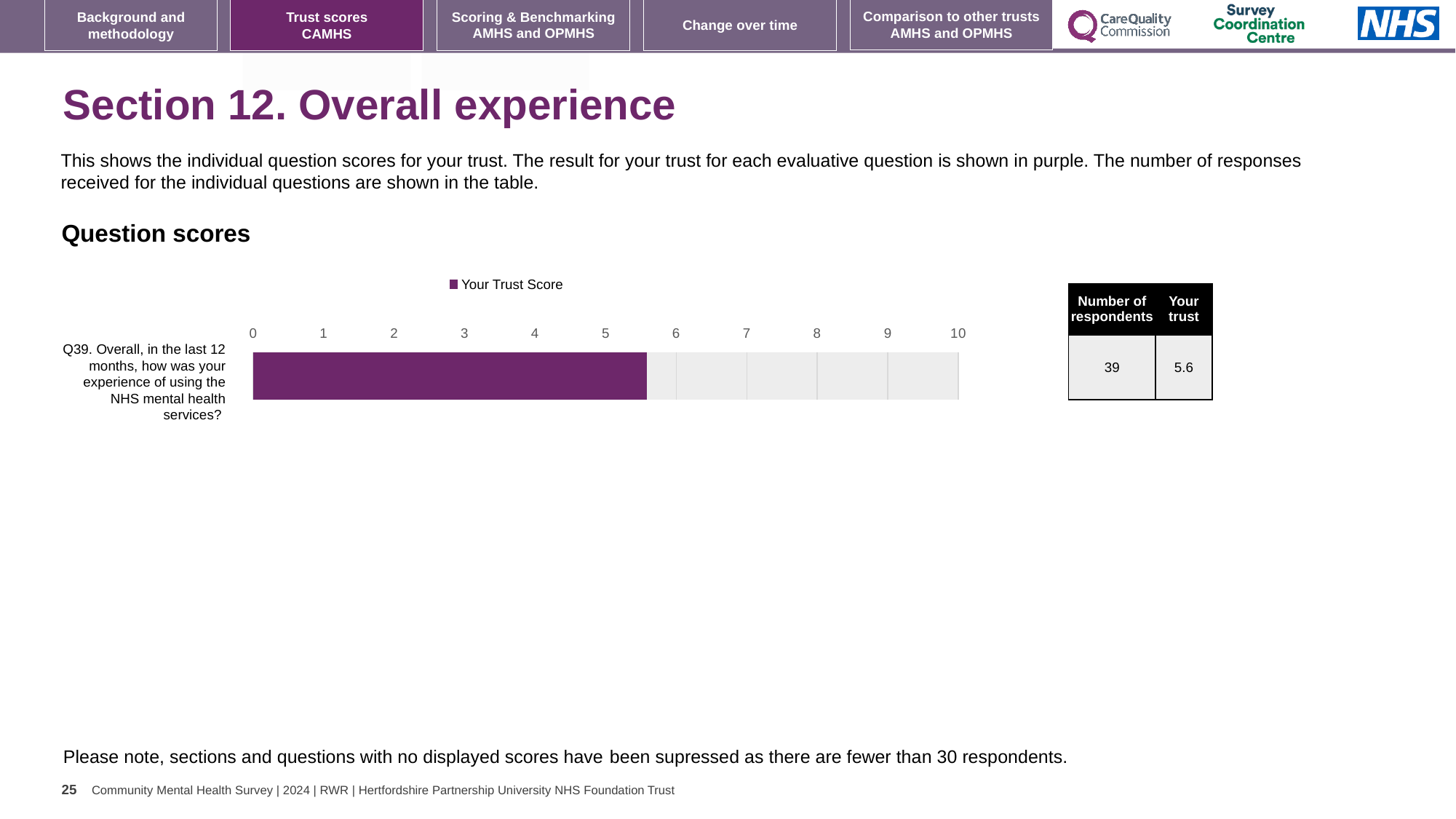
What is the highest value shown on the chart's axis? 10 Is the trust score for Q39 greater or less than 6? less What kind of chart is shown under 'Question scores'? bar chart How many questions (categories) are plotted in the chart? 1 Is the trust score for Q39 greater or less than 8? less What is the name of the series shown in the chart legend? Your Trust Score What is the trust score for Q39 as shown in the table next to the chart? 5.6 Is the trust score for Q39 greater or less than 5? greater How many series does the chart legend list? 1 How many respondents answered Q39 according to the table next to the chart? 39